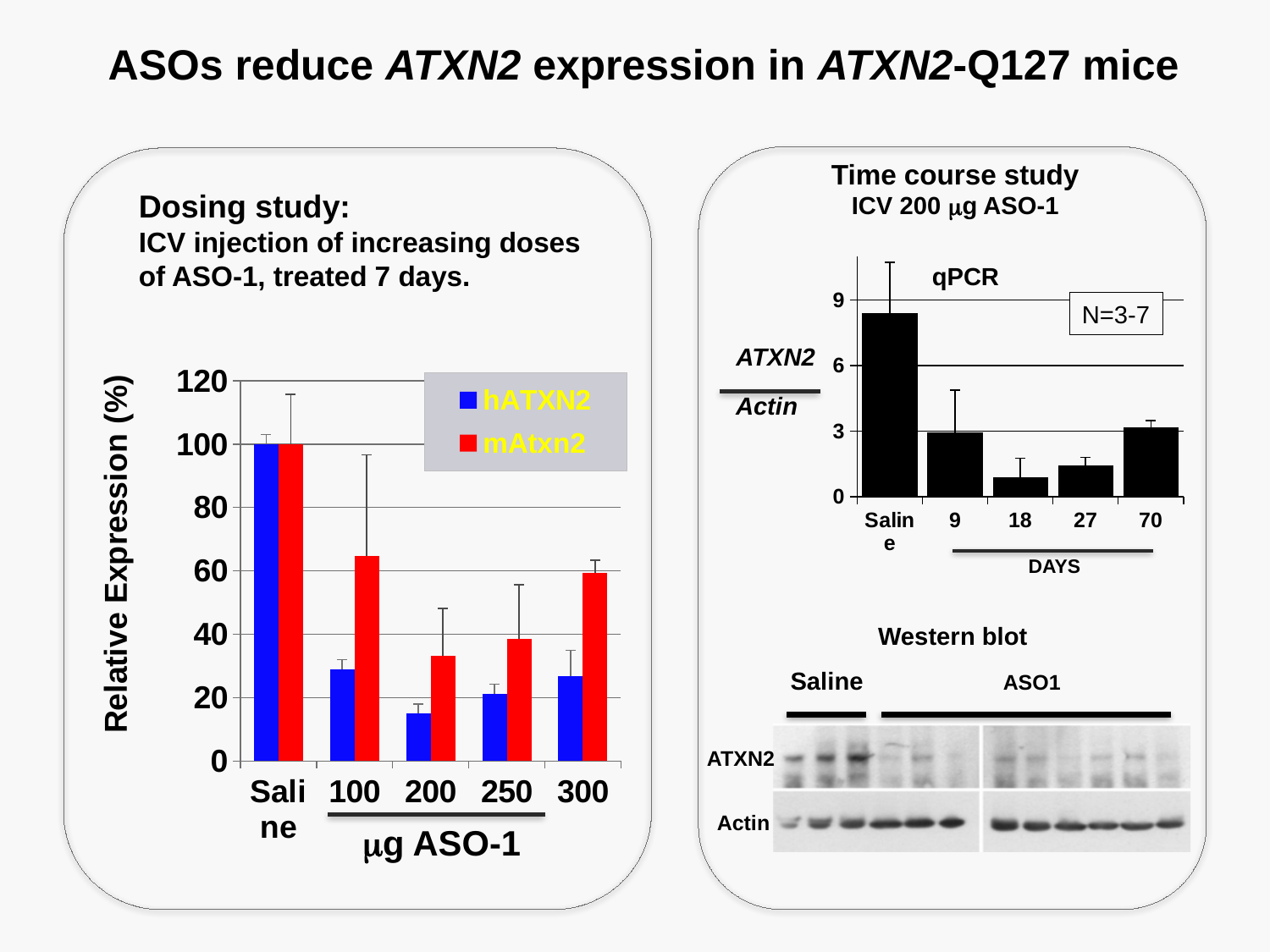
In the Dosing study chart, how many categories are shown on the x axis? 5 In the Time course study chart, at which number of days is the ATXN2/Actin value lowest? 18 In the Dosing study chart, what kind of chart is shown? bar chart In the Time course study chart, is the Saline value greater or less than 6? greater In the Dosing study chart, at 100 µg ASO-1, which is larger: hATXN2 or mAtxn2? mAtxn2 In the Dosing study chart, which colour represents mAtxn2? red In the Dosing study chart, at which dose is the hATXN2 value lowest? 200 In the Dosing study chart, what is the hATXN2 value for Saline? 100 In the Time course study chart, which category has the highest ATXN2/Actin value? Saline In the Dosing study chart, is the mAtxn2 value at 100 µg greater or less than 60? greater In the Dosing study chart, is the hATXN2 value at 200 µg greater or less than 20? less In the Dosing study chart, how many series does the legend list? 2